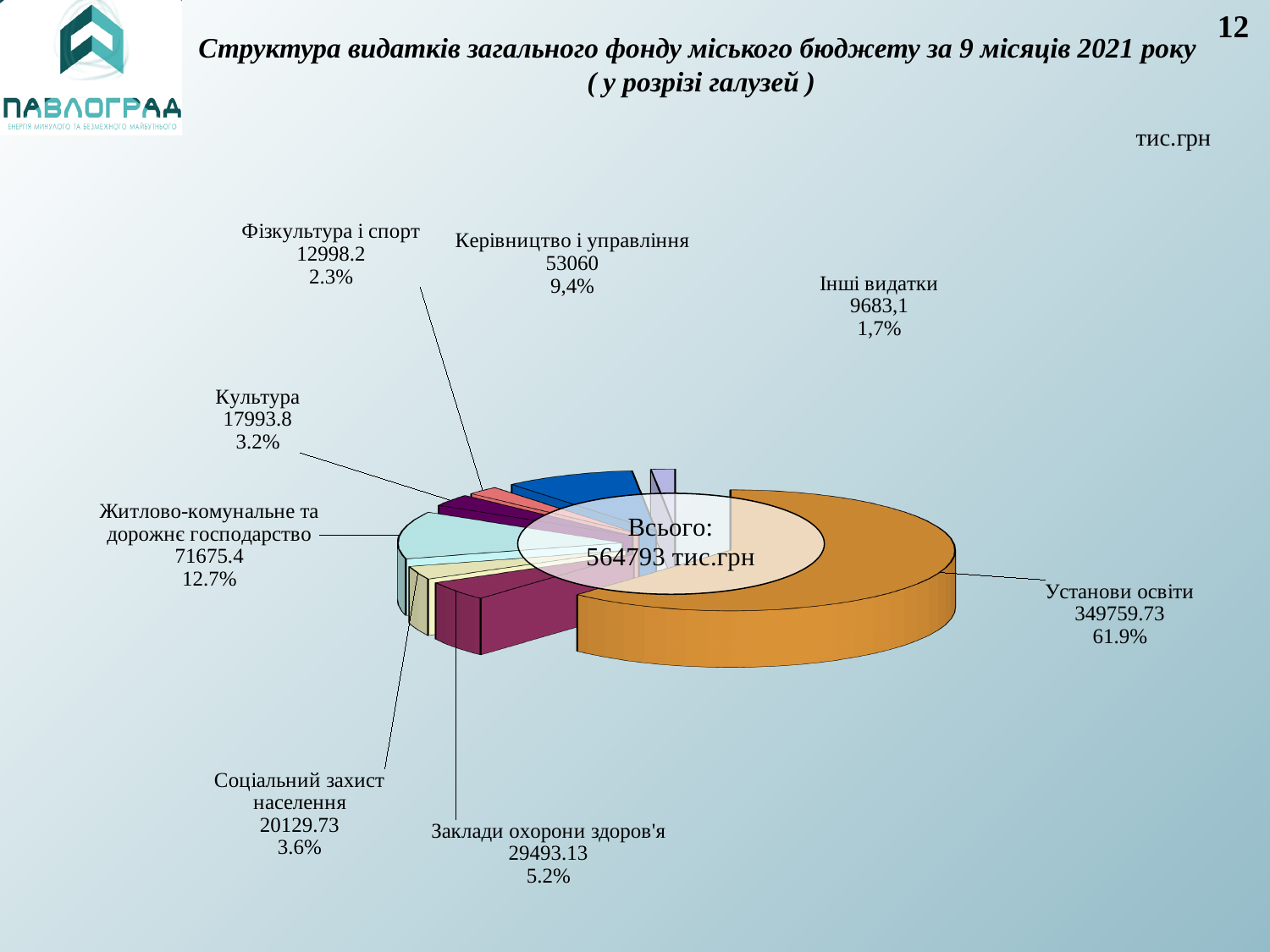
What share of the pie does Установи освіти represent? 61.9% How many categories (slices) does the pie chart show? 8 What kind of chart is shown on the slide? pie chart What is the value for Установи освіти? 349759.73 What is the value for Житлово-комунальне та дорожнє господарство? 71675.4 Which category has the smallest share of the pie? Інші видатки What total is shown in the centre of the pie chart? 564793 тис.грн What unit is indicated for the values on the slide? тис.грн Which category has the largest share of the pie? Установи освіти What percentage is shown for Керівництво і управління? 9,4% What is the difference between the values for Заклади охорони здоров'я and Соціальний захист населення? 9363.4 Which is larger, Культура or Фізкультура і спорт? Культура